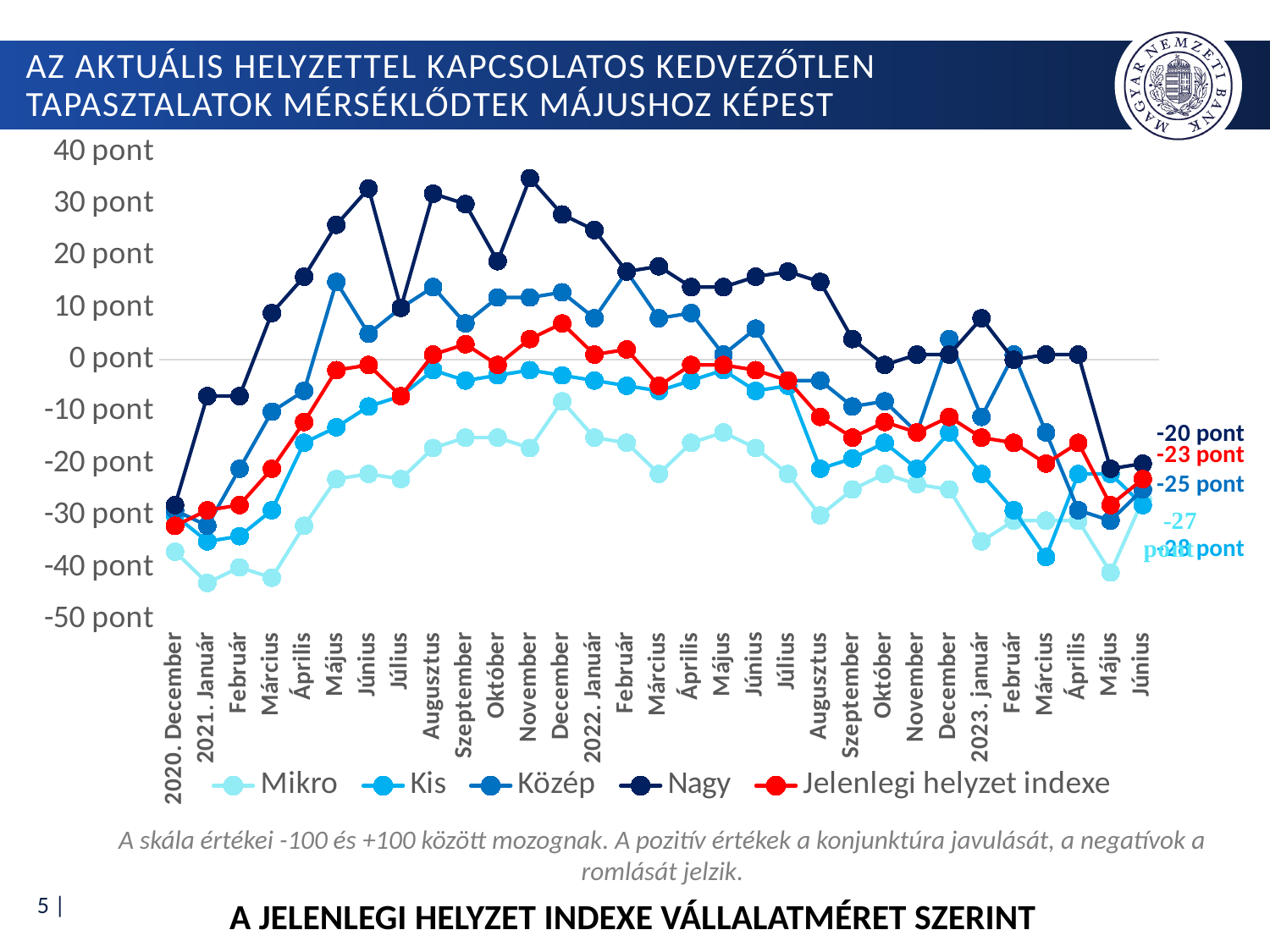
Which series has the lowest value in 2021 Január? Mikro What is the value of the Nagy series at 2023 Június? -20 pont What is the value of the Közép series at 2023 Június? -25 pont Does the Nagy series rise or fall from 2020 December to 2021 Május? rise What kind of chart is shown on the slide? line chart What is the value of the Jelenlegi helyzet indexe series at 2023 Június? -23 pont What is the difference between the Nagy value and the Jelenlegi helyzet indexe value at 2023 Június? 3 pont How many series does the legend list? 5 At 2023 Június, which is larger: the Nagy value or the Közép value? Nagy Is the value for Nagy in 2021 November greater or less than 30 pont? greater Is the value for Mikro in 2021 Január greater or less than -40 pont? less Which series has the highest value in 2021 November? Nagy